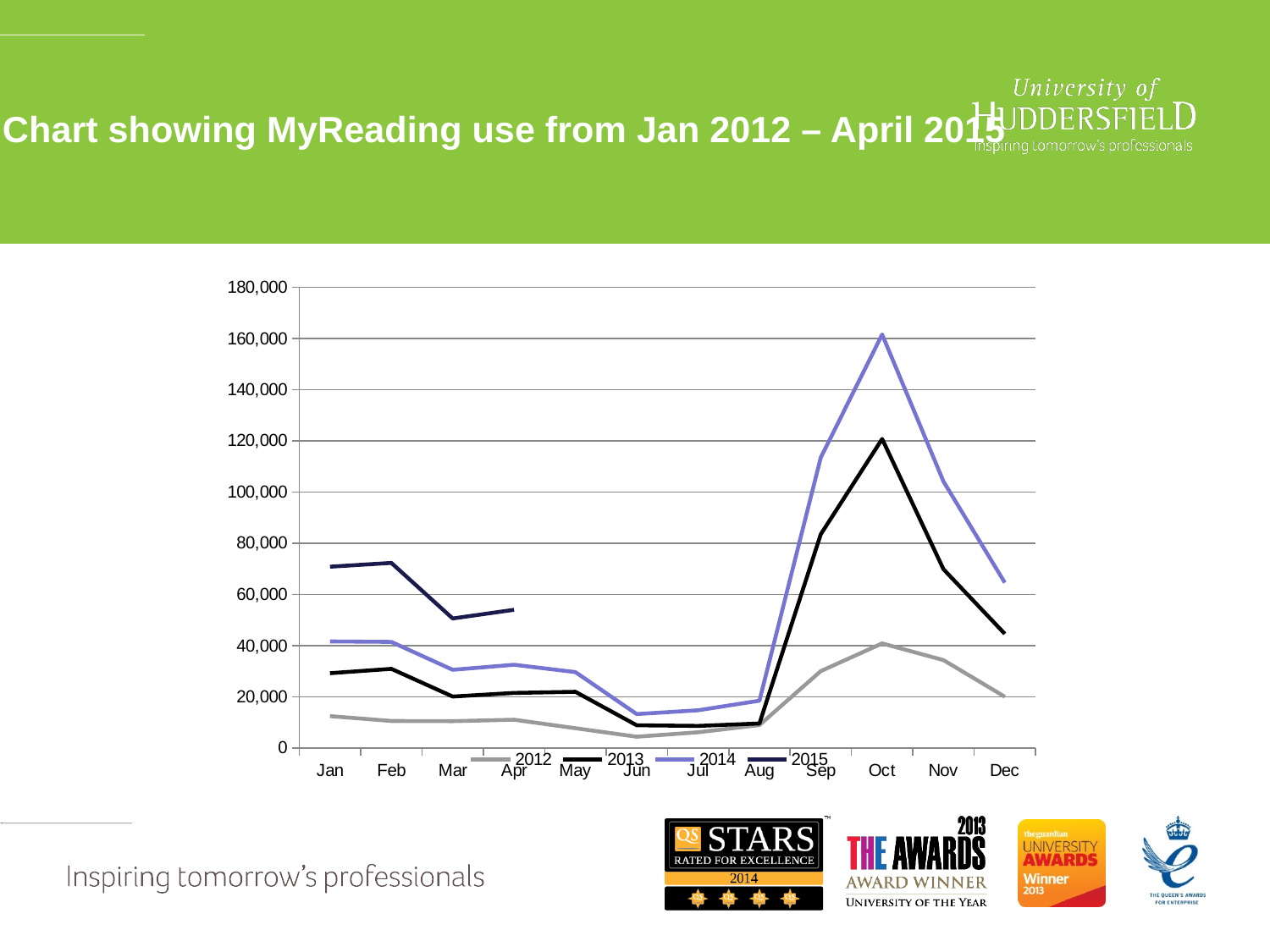
How many series does the legend list? 4 Is the value for 2012 in Oct greater or less than 60,000? less Is the value for 2015 in Jan greater or less than 60,000? greater Is the value for 2014 in Oct greater or less than 140,000? greater Which series has the larger value in Oct, 2013 or 2014? 2014 Which series only has data plotted from Jan to Apr? 2015 What kind of chart is shown on the slide? line chart In which month does the 2014 series reach its lowest value? Jun In which month does the 2014 series reach its highest value? Oct How many months are shown along the x axis? 12 Does the 2014 series rise or fall from Aug to Oct? rise